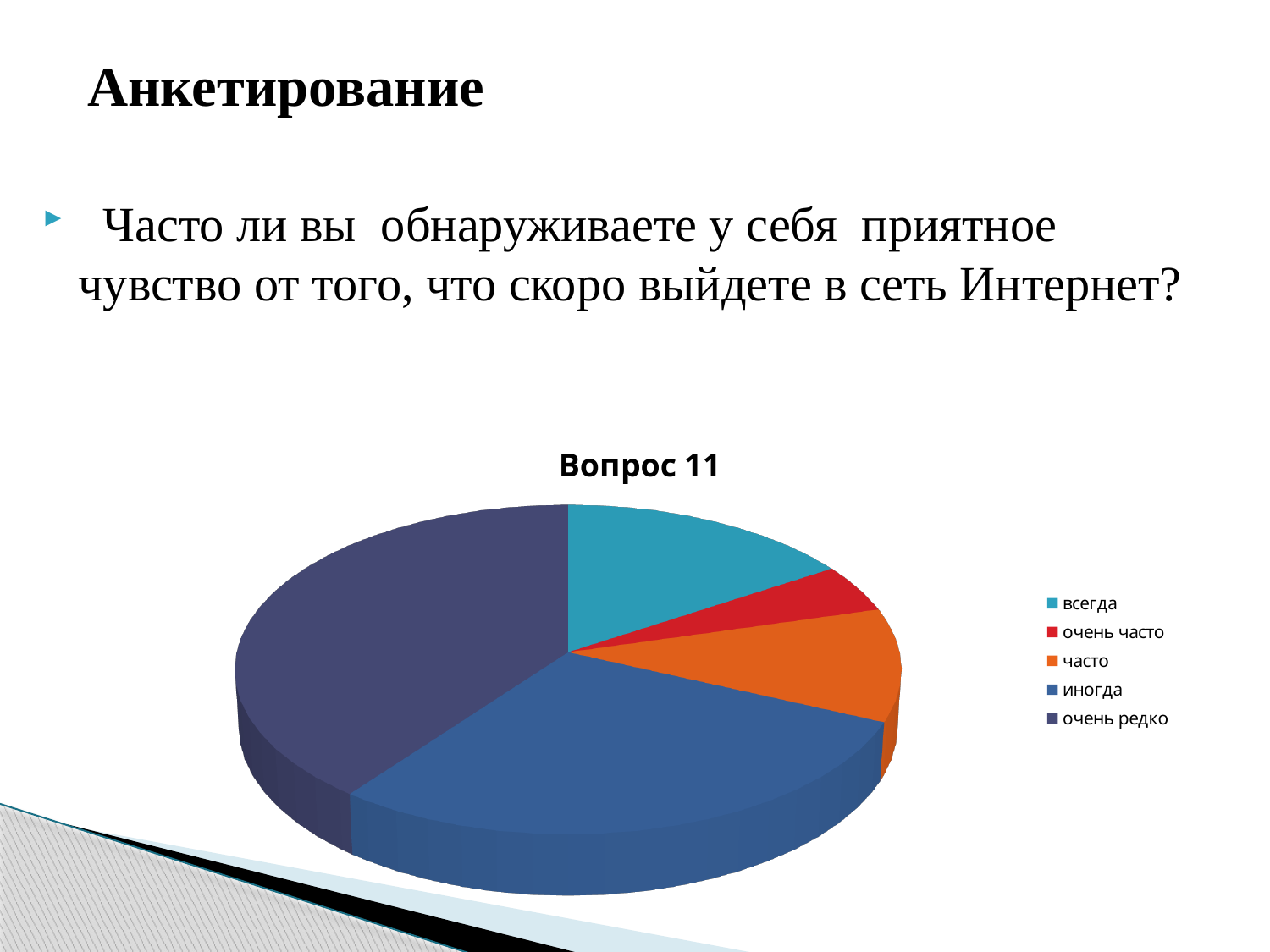
Which slice is larger, очень редко or часто? очень редко How many categories does the pie chart have? 5 Which category has the smallest slice of the pie? очень часто Which slice is larger, иногда or всегда? иногда Which slice is larger, всегда or очень часто? всегда What kind of chart is shown on the slide? pie chart What is the title of the chart? Вопрос 11 How many entries does the legend list? 5 Which legend entry is shown in red? очень часто